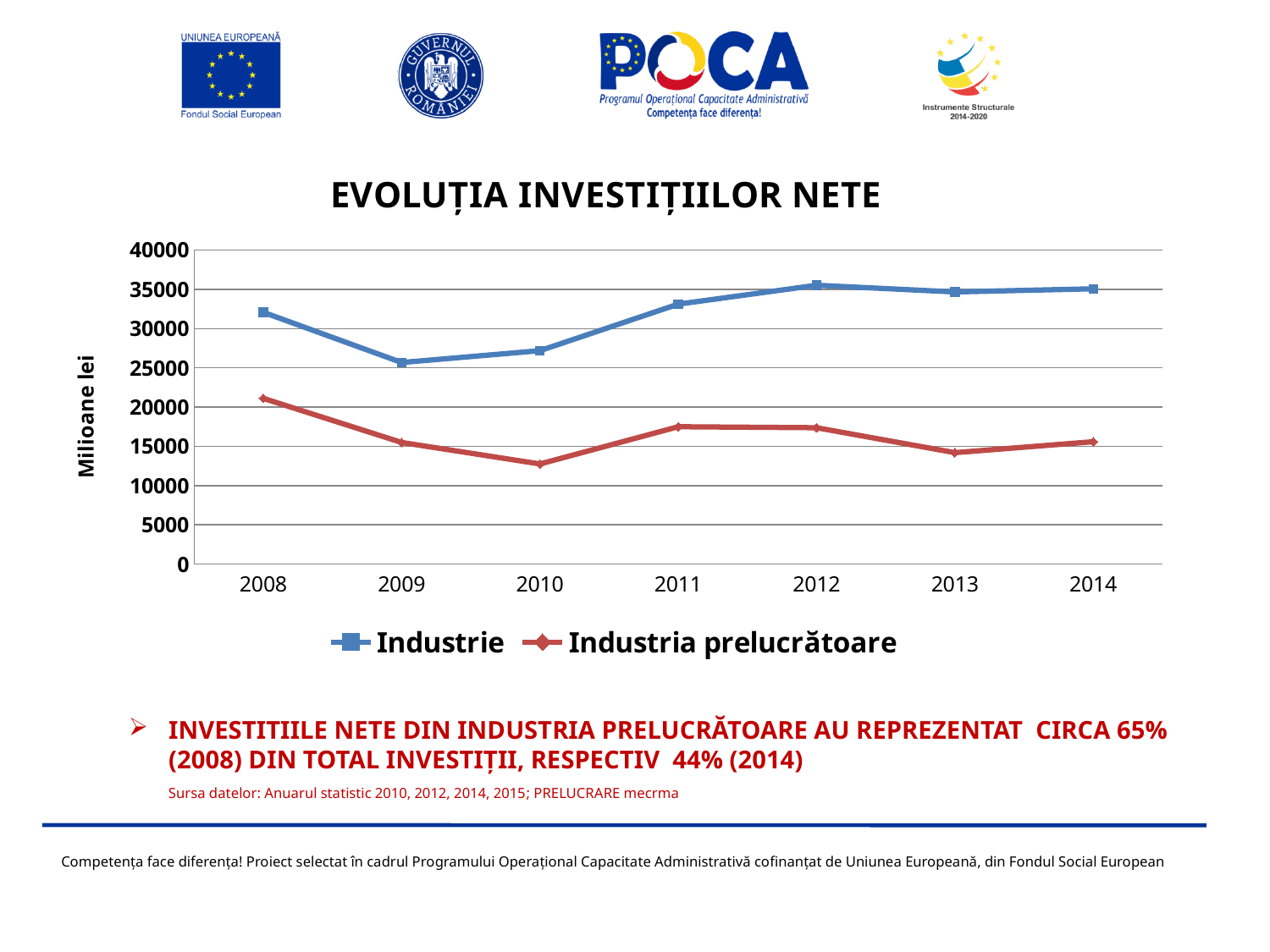
What is the label on the y axis of the chart? Milioane lei How many series does the legend list? 2 Is the value for Industrie in 2009 greater or less than 30000? less In which year is the value for Industria prelucrătoare highest? 2008 Is the value for Industrie in 2008 greater or less than 30000? greater What kind of chart is shown on the slide? line chart Is the value for Industria prelucrătoare in 2010 greater or less than 15000? less How many years are plotted along the x axis? 7 Which series has the larger value in 2012, Industrie or Industria prelucrătoare? Industrie In which year is the value for Industria prelucrătoare lowest? 2010 Does the value for Industrie rise or fall from 2009 to 2012? rise In which year is the value for Industrie lowest? 2009